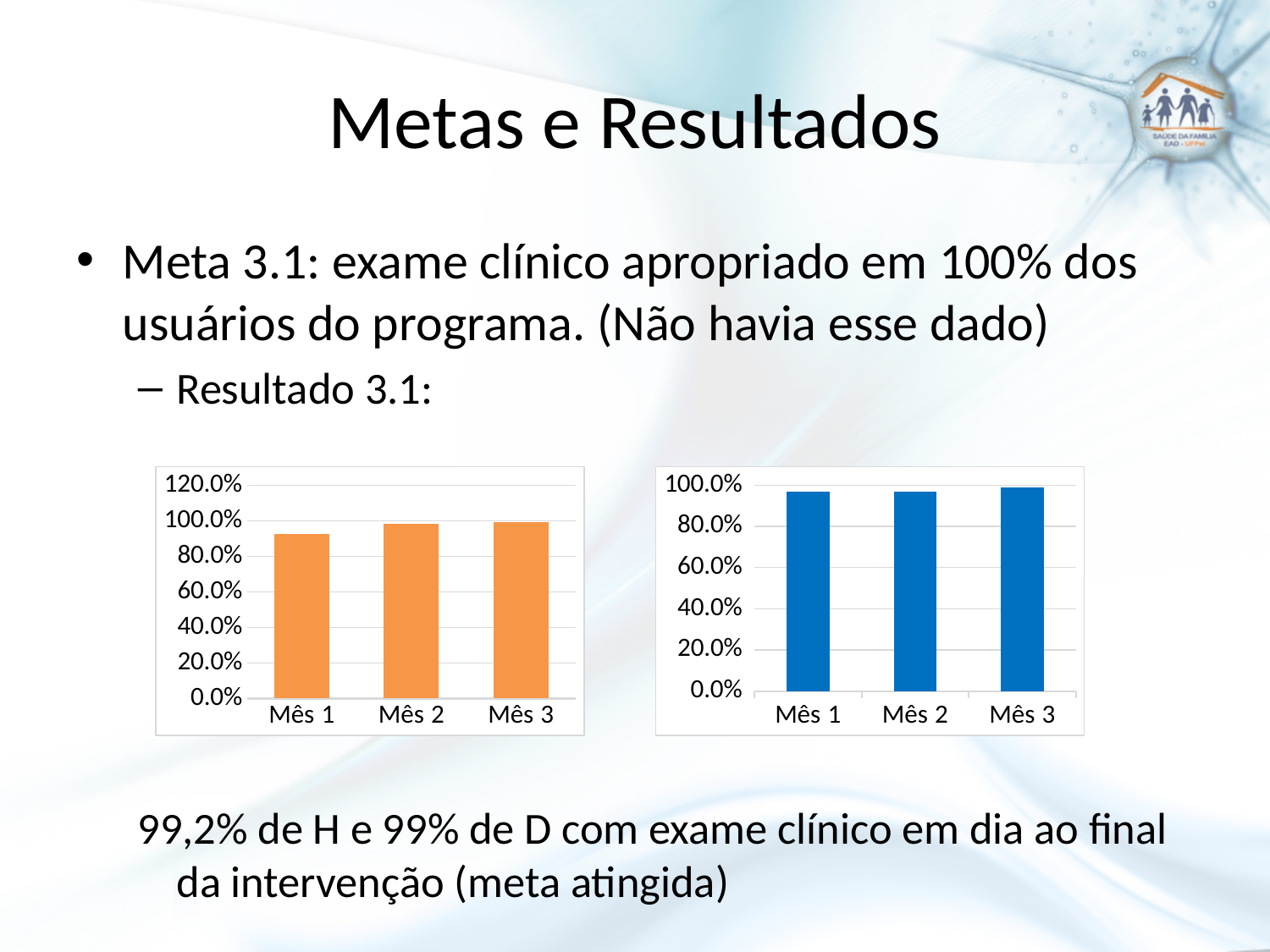
What is the highest tick value shown on the y axis of the left chart? 120.0% In the right chart, how many bars are plotted? 3 In the left chart, how many categories are shown on the x axis? 3 In the left chart, is the value for Mês 1 greater or less than 80.0%? greater In the right chart, is the value for Mês 2 greater or less than 60.0%? greater In the left chart, which month has the lowest bar? Mês 1 What colour are the bars in the left chart? orange What kind of chart is the right chart on the slide? bar chart What kind of chart is the left chart on the slide? bar chart In the left chart, do the values rise or fall from Mês 1 to Mês 3? rise In the right chart, is the value for Mês 1 greater or less than 80.0%? greater